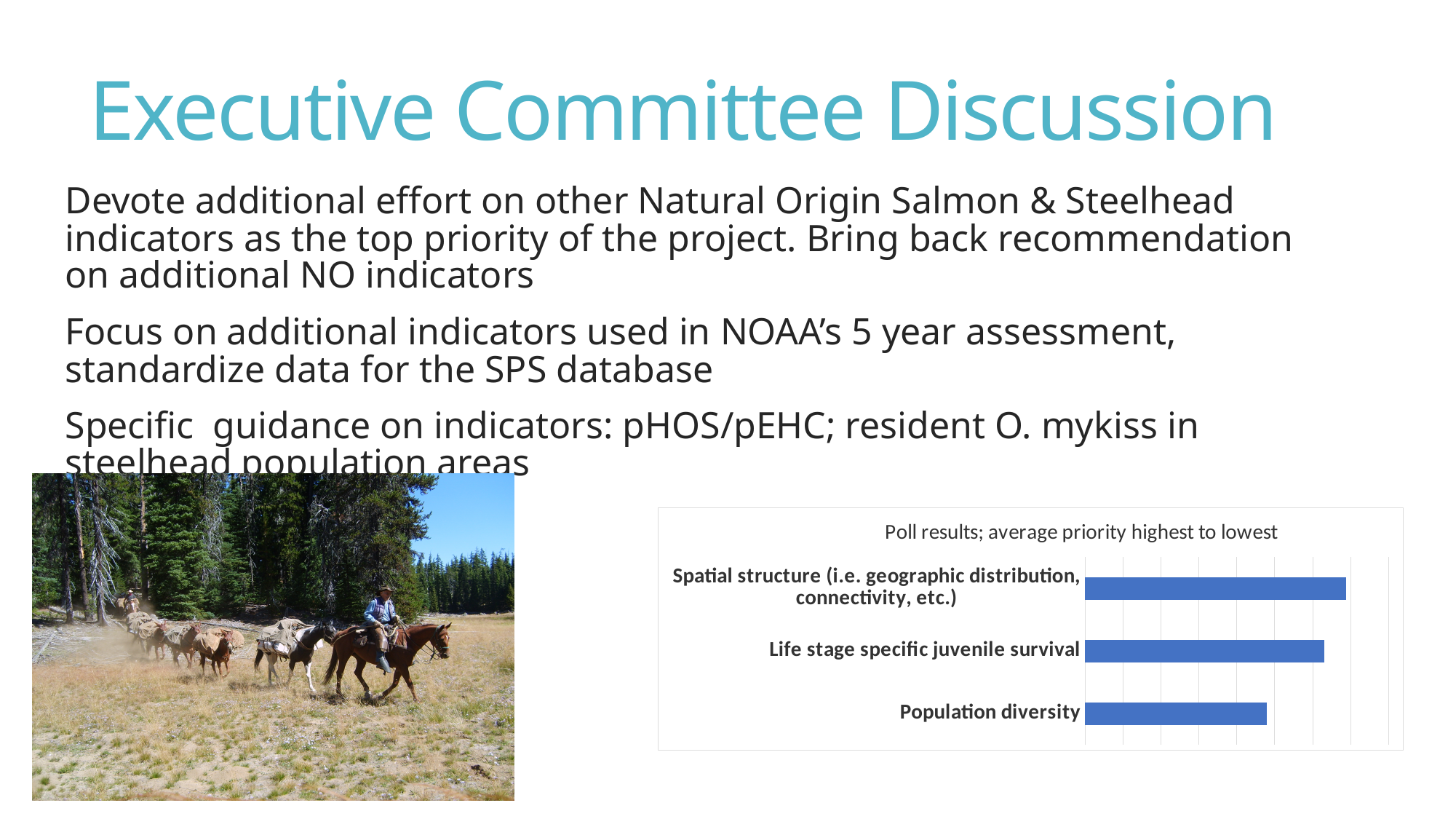
Which has the larger value: Spatial structure or Population diversity? Spatial structure What colour are the bars in the chart? Blue Do the bar lengths increase or decrease going from the top category to the bottom category? Decrease Which category has the longest bar in the chart? Spatial structure (i.e. geographic distribution, connectivity, etc.) Which category is listed at the bottom of the chart? Population diversity What is the title of the chart? Poll results; average priority highest to lowest Which category has the shortest bar in the chart? Population diversity How many categories are plotted in the chart? 3 Which has the larger value: Life stage specific juvenile survival or Population diversity? Life stage specific juvenile survival What kind of chart is shown on the slide? Bar chart